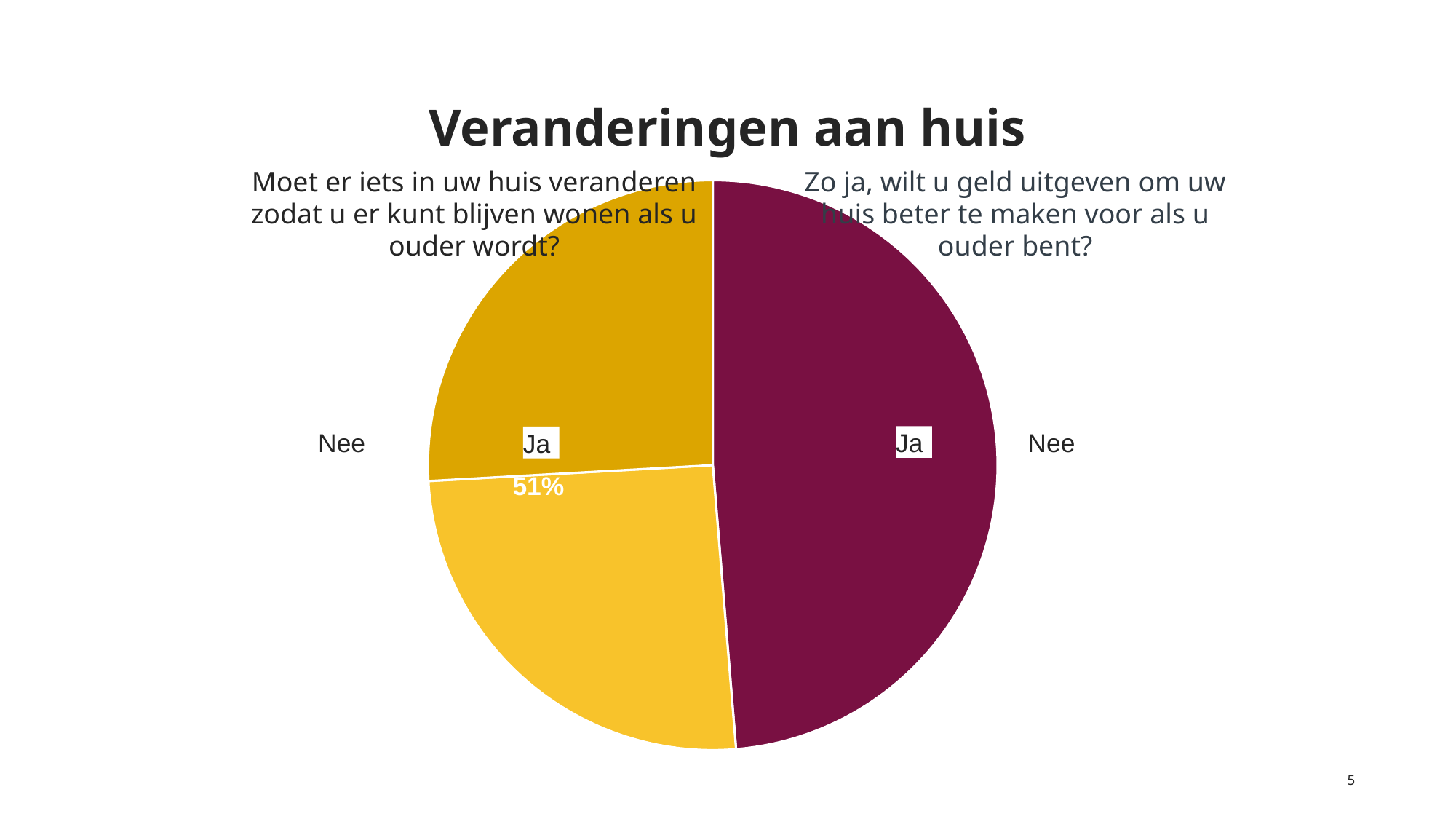
What is the title of the slide's chart? Veranderingen aan huis Which colour slice is the largest in the pie chart? the dark magenta slice What kind of chart is shown on the slide? pie chart How many slices does the pie chart have? 3 What percentage value is printed as a data label on the pie chart? 51% Which category labels appear around the pie chart? Ja and Nee